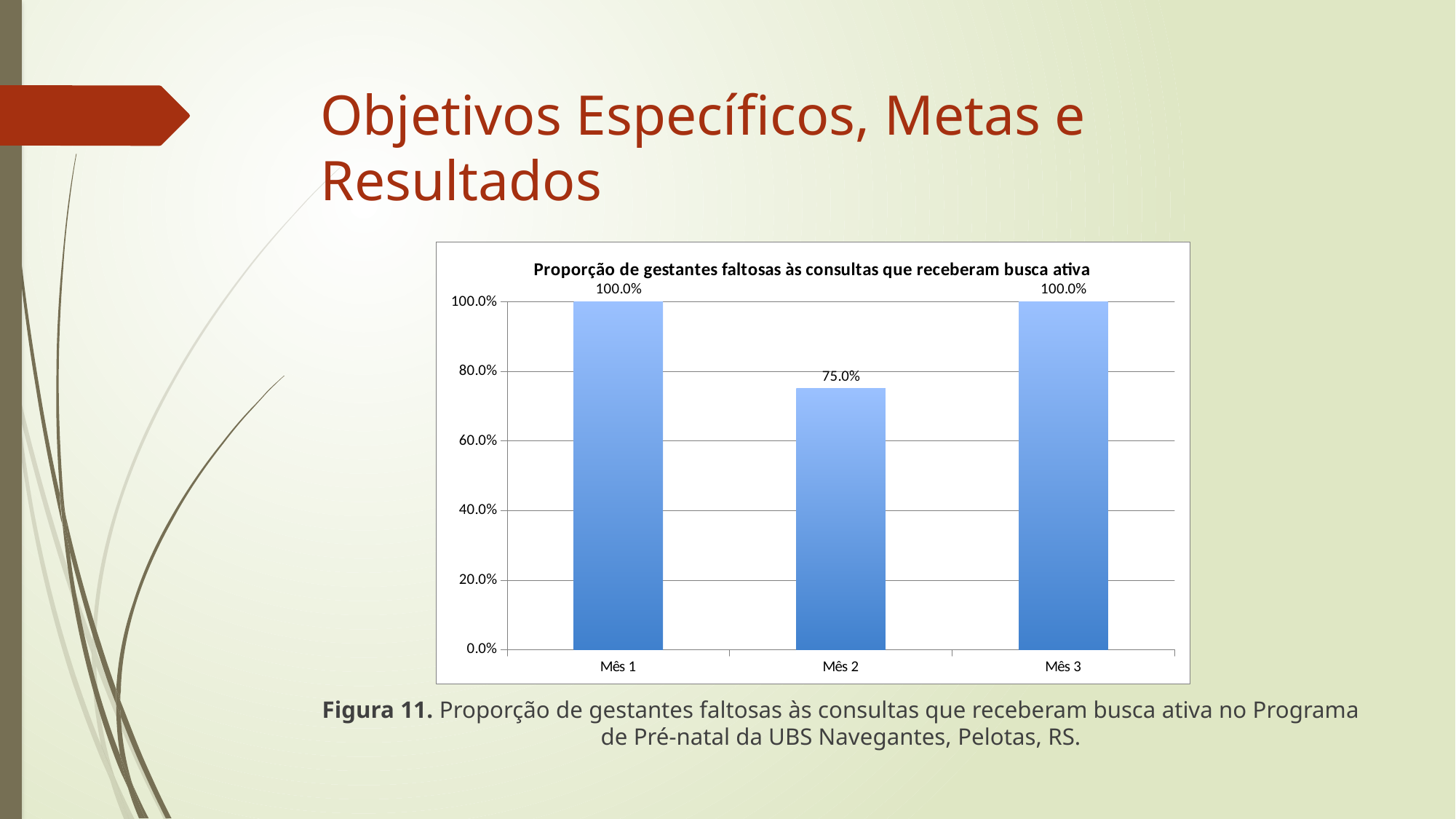
Which month has the lowest value? Mês 2 What is the value for Mês 2? 75.0% What is the value for Mês 1? 100.0% What is the title of the chart? Proporção de gestantes faltosas às consultas que receberam busca ativa What kind of chart is shown on the slide? bar chart What is the highest value shown on the y axis? 100.0% How many months are shown on the x axis? 3 Which is larger, the value for Mês 2 or the value for Mês 3? Mês 3 What is the difference between the values for Mês 1 and Mês 2? 25.0% Is the value for Mês 2 greater or less than 60.0%? greater What is the value for Mês 3? 100.0% Does the value fall or rise from Mês 2 to Mês 3? rise